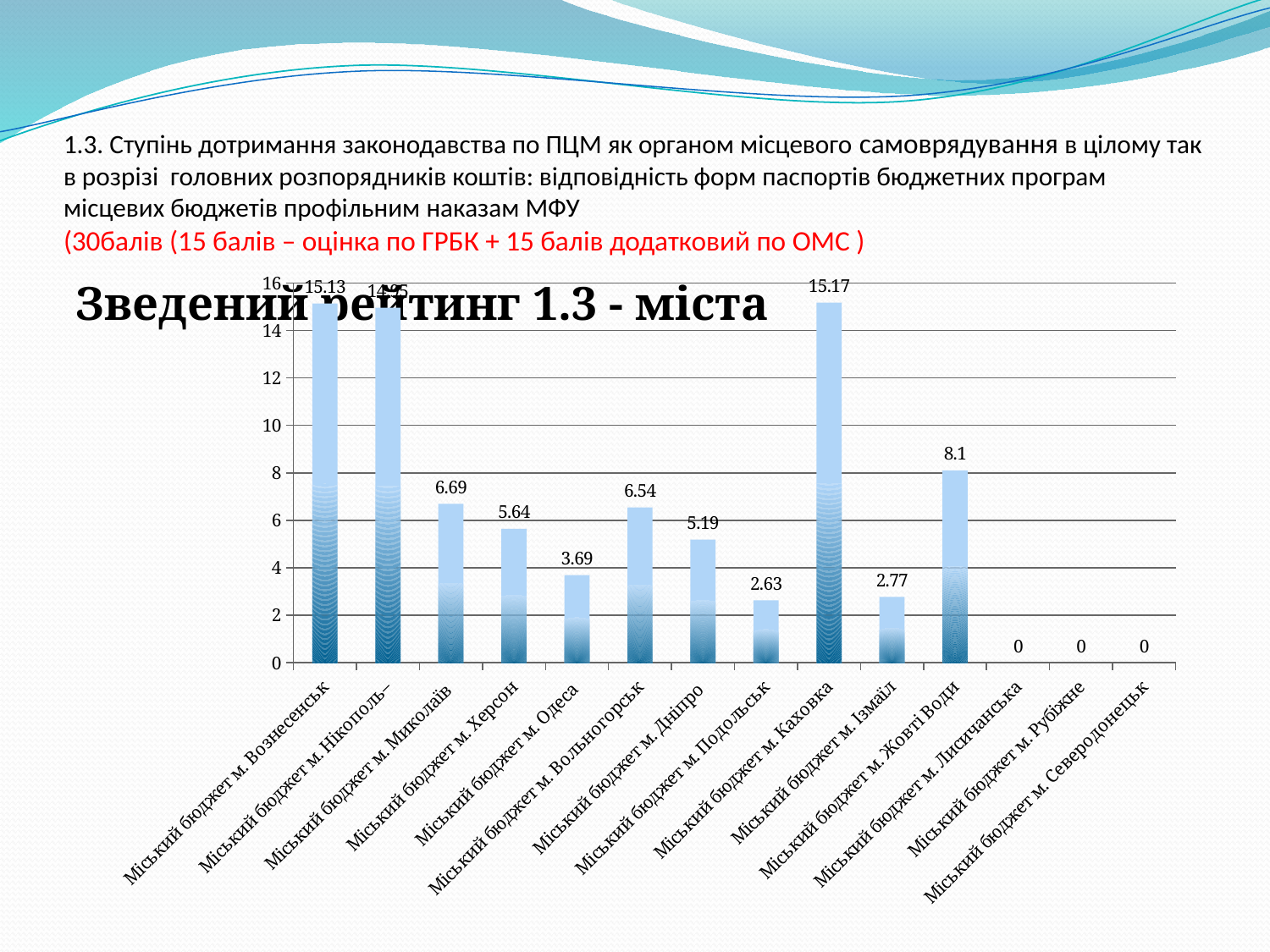
Which is larger, the value for Міський бюджет м. Херсон or Міський бюджет м. Дніпро? Міський бюджет м. Херсон What is the title of the chart? Зведений рейтинг 1.3 - міста What is the value for Міський бюджет м. Каховка? 15.17 Is the value for Міський бюджет м. Одеса greater or less than 4? less What is the difference between the values for Міський бюджет м. Жовті Води and Міський бюджет м. Миколаїв? 1.41 What is the value for Міський бюджет м. Подольськ? 2.63 How many city budgets (categories) are shown on the x axis? 14 What is the value for Міський бюджет м. Жовті Води? 8.1 What kind of chart is shown on the slide? bar chart Is the value for Міський бюджет м. Вознесенськ greater or less than 14? greater What is the value for Міський бюджет м. Рубіжне? 0 What is the value for Міський бюджет м. Миколаїв? 6.69